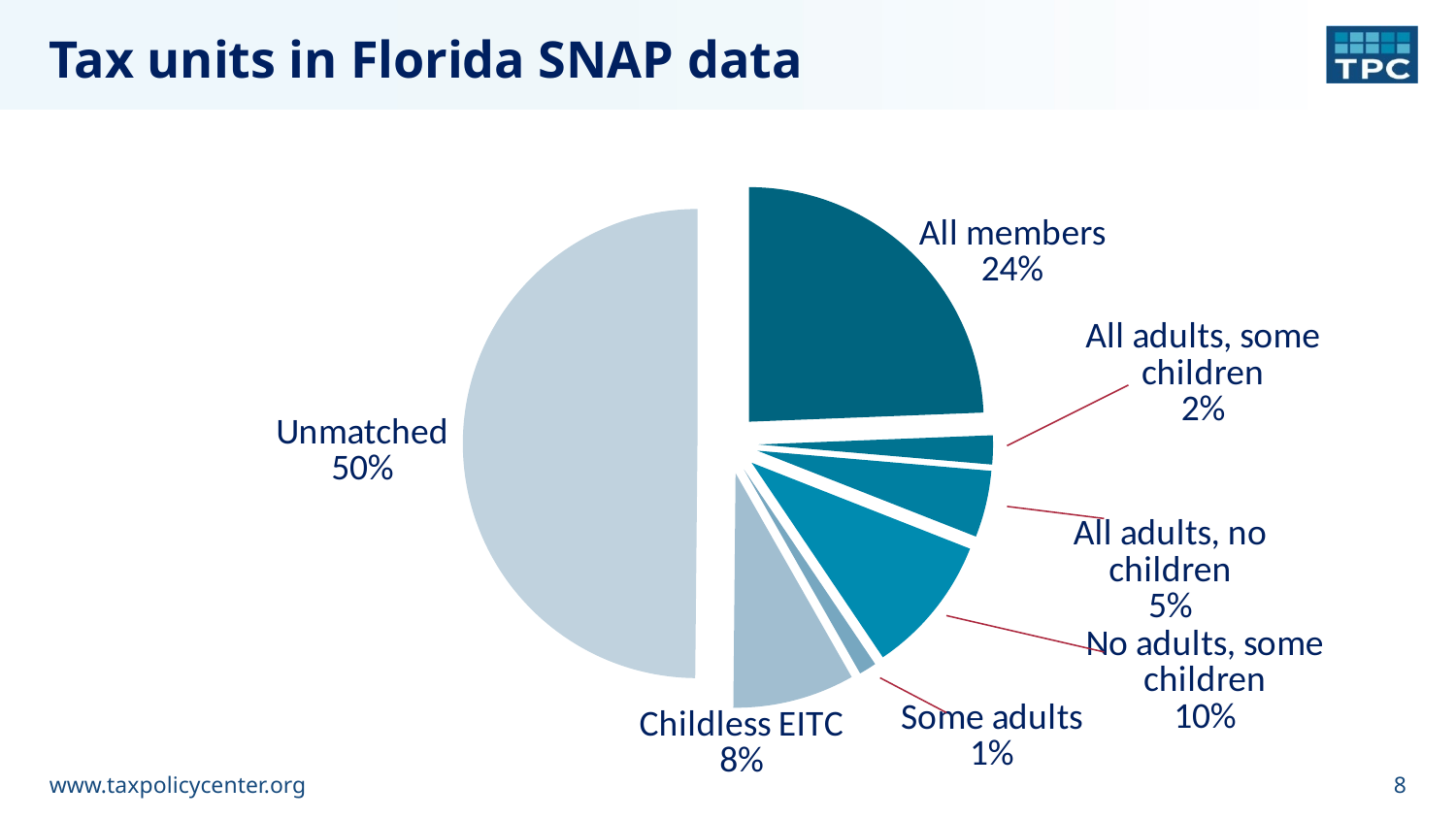
Which category has the smallest share of the pie? Some adults What kind of chart is shown on the slide? Pie chart What is the difference between the Unmatched share and the All members share? 26% What share of tax units is Unmatched? 50% How many slices does the pie chart have? 7 Which is larger, No adults, some children or Childless EITC? No adults, some children What is the value for Childless EITC? 8% What is the value for No adults, some children? 10% What is the value for All adults, no children? 5% Which category has the largest share of the pie? Unmatched What is the title of the chart? Tax units in Florida SNAP data What percentage of tax units is labelled All members? 24%